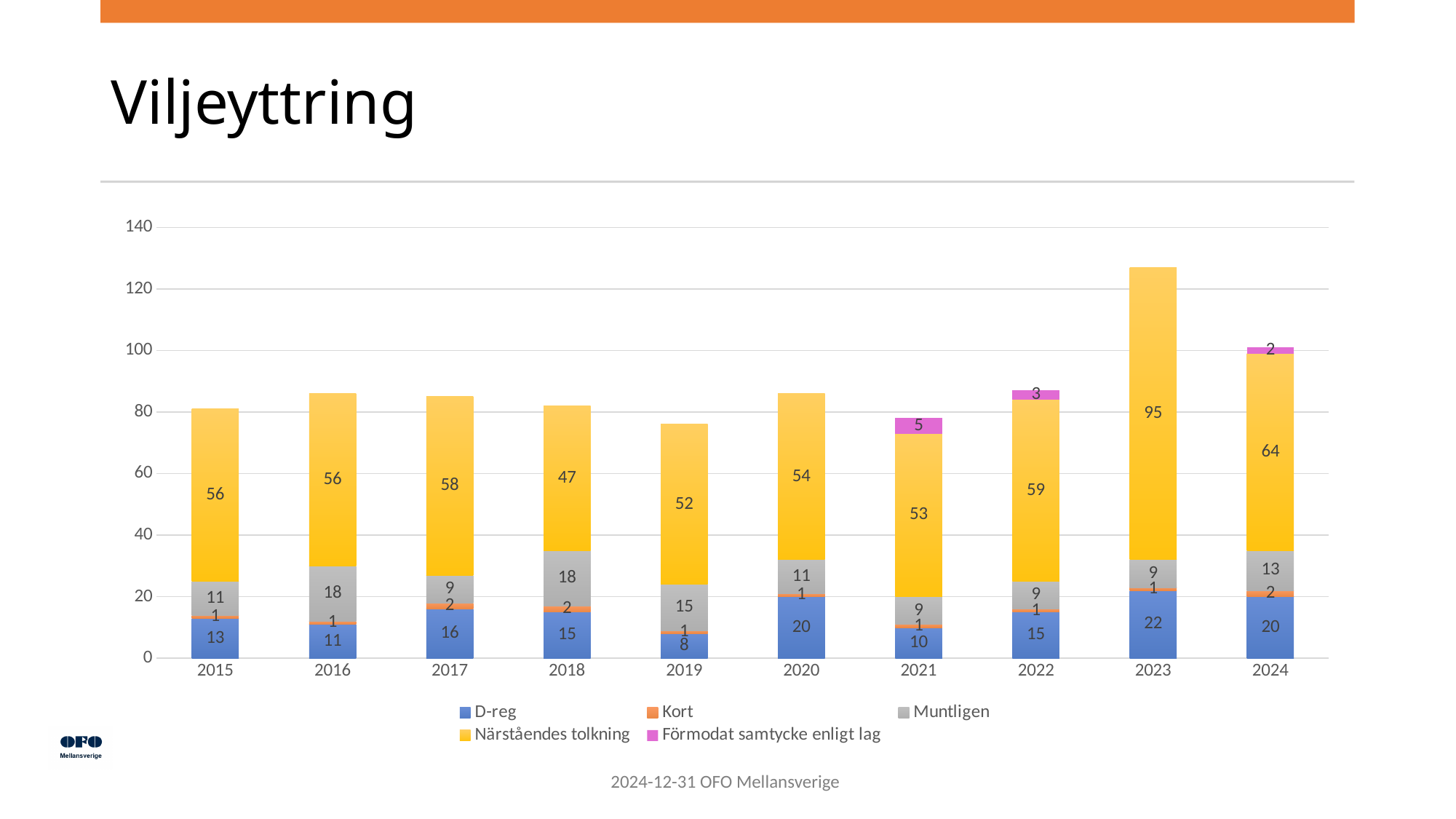
What is the value for Förmodat samtycke enligt lag in 2021? 5 What kind of chart is shown on the slide? Stacked bar chart Which year has the larger Muntligen value, 2016 or 2017? 2016 What is the total of the stacked bar for 2015? 81 In which year is the D-reg value lowest? 2019 What is the value for Närståendes tolkning in 2023? 95 What is the value for D-reg in 2019? 8 How many series does the legend list? 5 Is the total height of the 2023 stacked bar greater or less than 120? greater How many years are shown on the x axis? 10 What is the difference between the Närståendes tolkning values for 2023 and 2024? 31 In which year is the Närståendes tolkning value highest? 2023